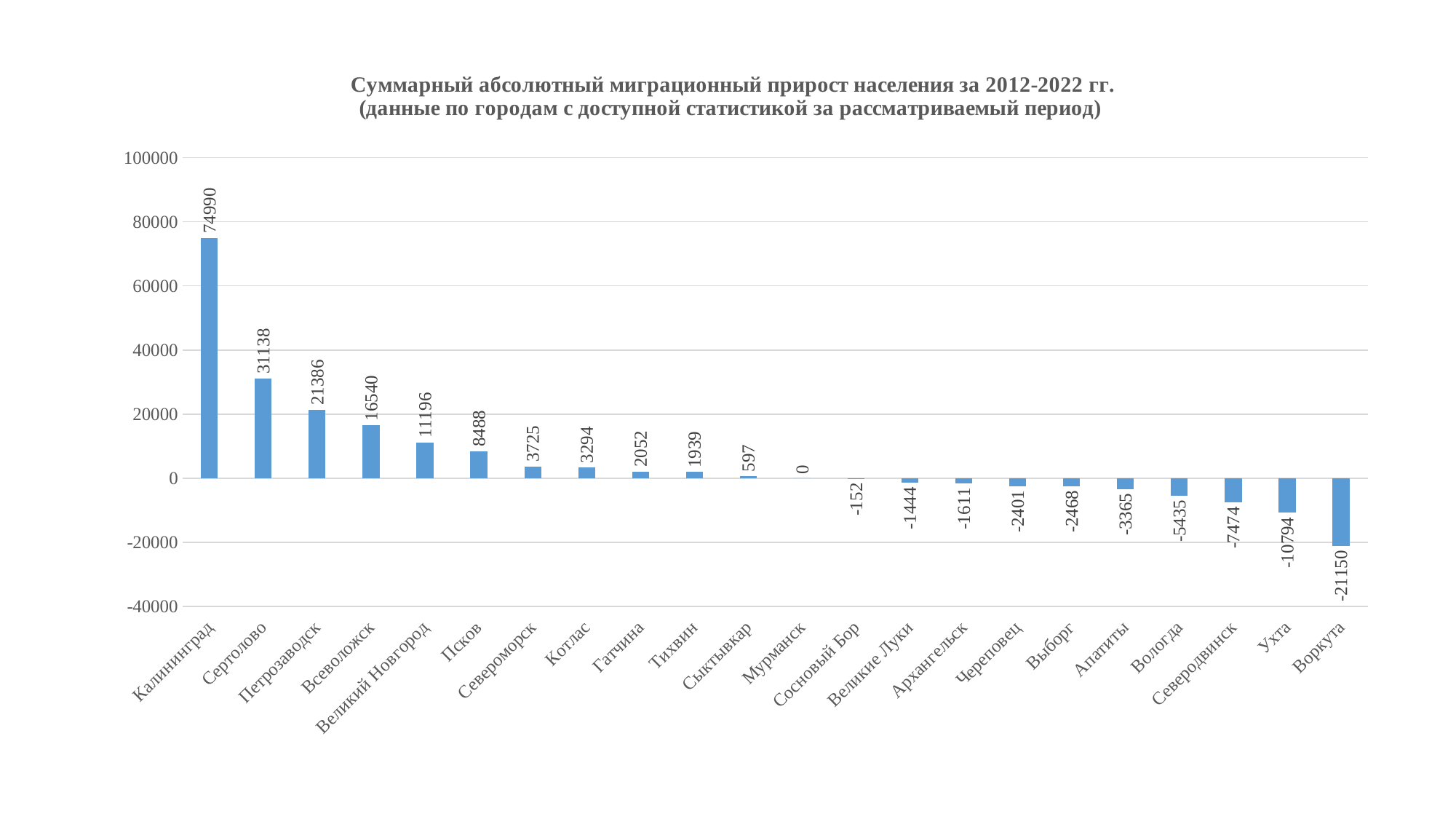
What is the difference between the values for Сертолово and Петрозаводск? 9752 Which city has the highest value? Калининград What is the value for Великий Новгород? 11196 Which city has the lowest value? Воркута What is the value for Мурманск? 0 Is the value for Всеволожск greater or less than 20000? less Which is larger, the value for Псков or the value for Североморск? Псков What is the value for Воркута? -21150 What kind of chart is this? bar chart Do the values rise or fall from left to right along the x axis? fall How many cities are shown on the chart? 22 What is the value for Калининград? 74990